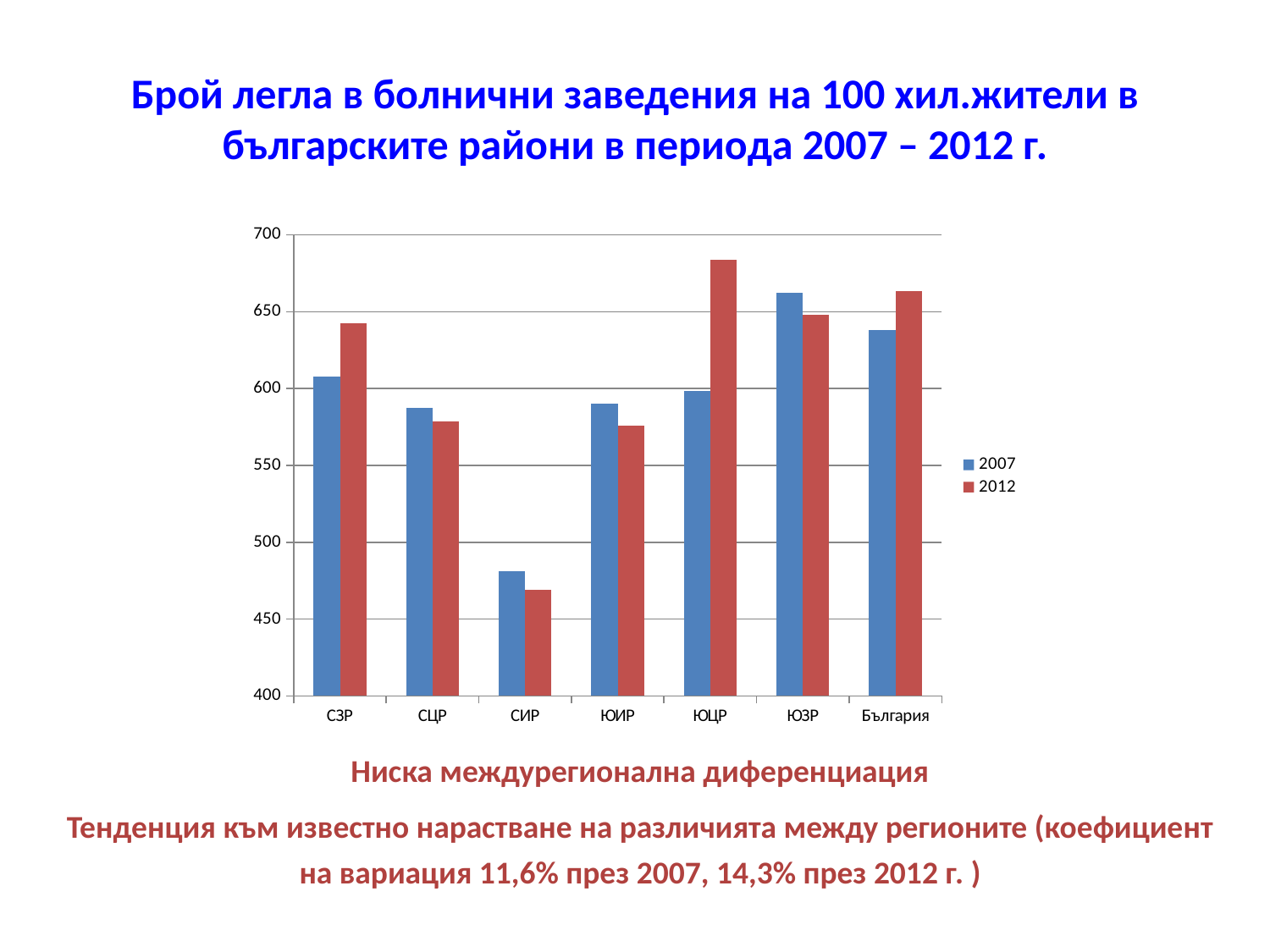
How many categories are shown on the x axis? 7 Which category has the lowest value for 2007? СИР Is the 2007 value for СИР greater or less than 500? less For СЗР, which is larger: the 2007 value or the 2012 value? 2012 What kind of chart is shown on the slide? bar chart Is the 2007 value for България greater or less than 650? less Which colour represents the 2012 series in the legend? red How many series does the legend list? 2 Which category has the lowest value for 2012? СИР Which category has the highest value for 2012? ЮЦР Which category has the highest value for 2007? ЮЗР Is the 2012 value for ЮЦР greater or less than 650? greater